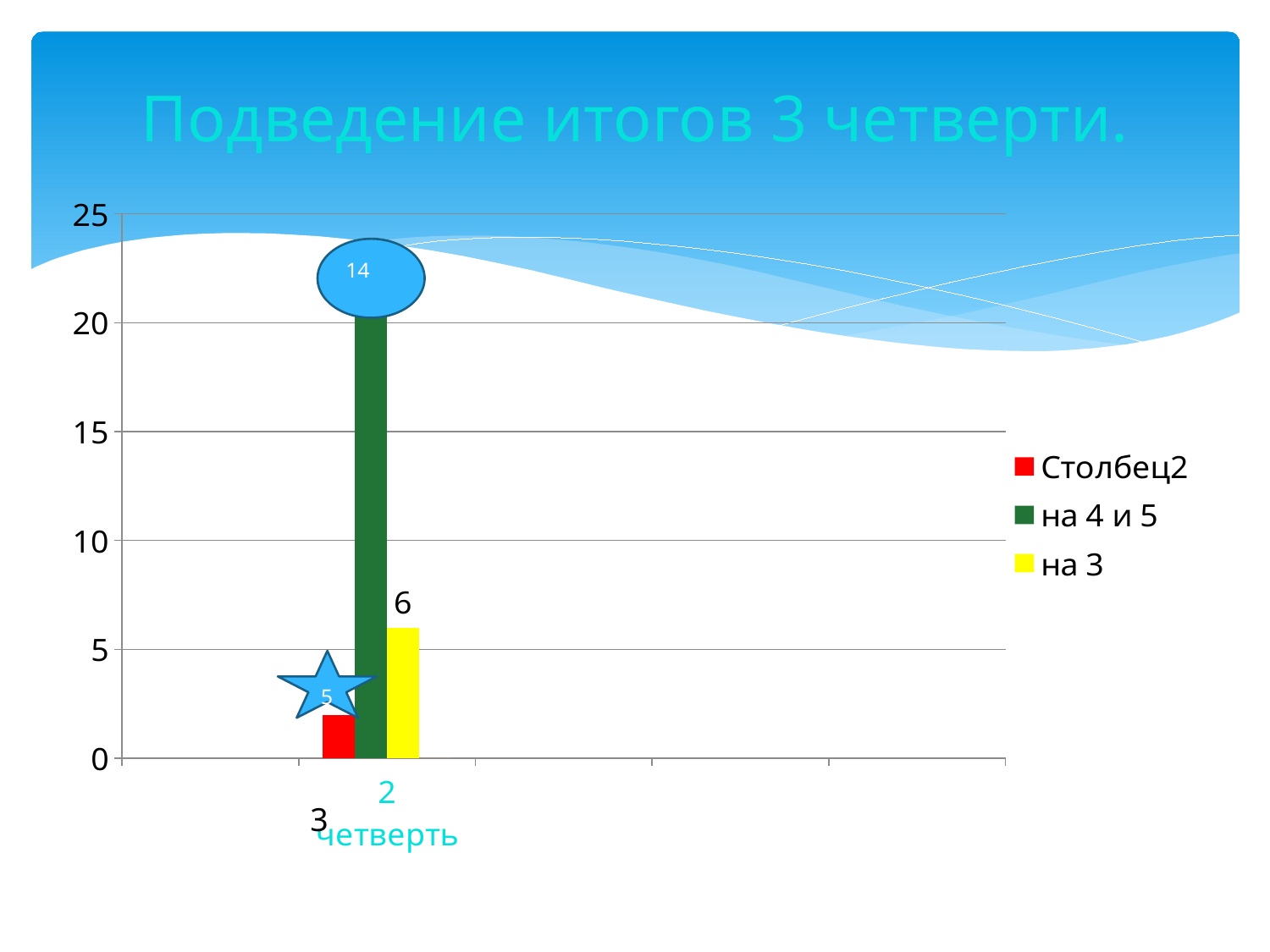
Which series has the highest bar? на 4 и 5 Which series is shown in yellow in the legend? на 3 Is the value for "Столбец2" greater or less than 5? less Which series has the lowest bar? Столбец2 Which is larger, the "на 3" bar or the "Столбец2" bar? на 3 How many bars are plotted on the chart? 3 What is the title of the chart on the slide? Подведение итогов 3 четверти. How many series does the legend list? 3 What is the highest value shown on the vertical axis? 25 What is the value of the "на 3" series? 6 What kind of chart is shown on the slide? bar chart Is the value for "на 4 и 5" greater or less than 15? greater